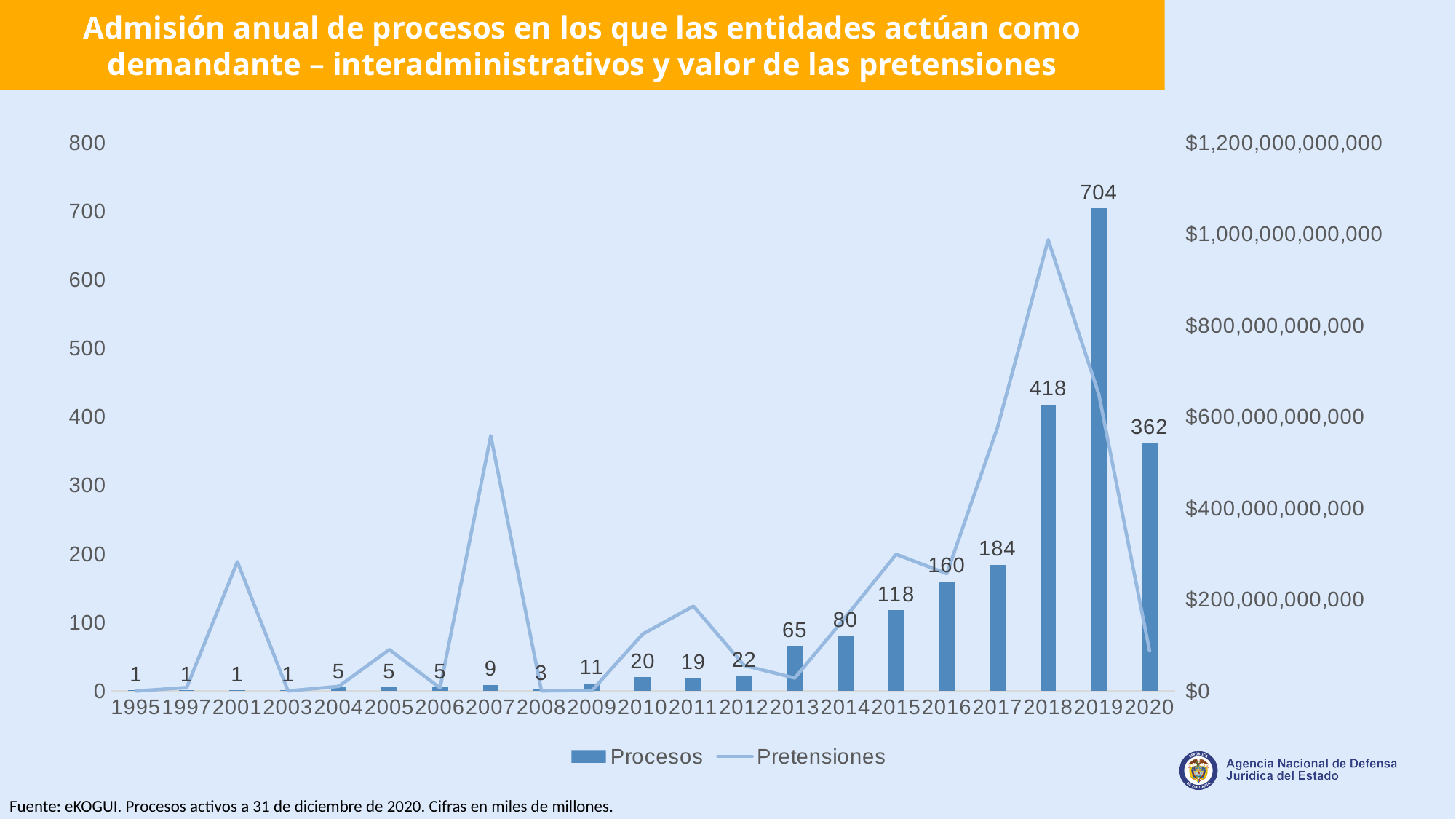
What kinds of chart are combined on this slide? Bar chart and line chart Is the Pretensiones value for 2020 greater or less than $200,000,000,000? less How many series does the legend list? 2 How many years are shown on the x axis? 21 Do the Procesos values generally rise or fall from 2009 to 2019? rise Which year has the highest number of Procesos? 2019 What is the difference in Procesos between 2019 and 2020? 342 What is the number of Procesos for 2018? 418 What is the number of Procesos for 2019? 704 Is the Pretensiones value for 2018 greater or less than $800,000,000,000? greater Which year has more Procesos, 2016 or 2017? 2017 What is the number of Procesos for 2013? 65